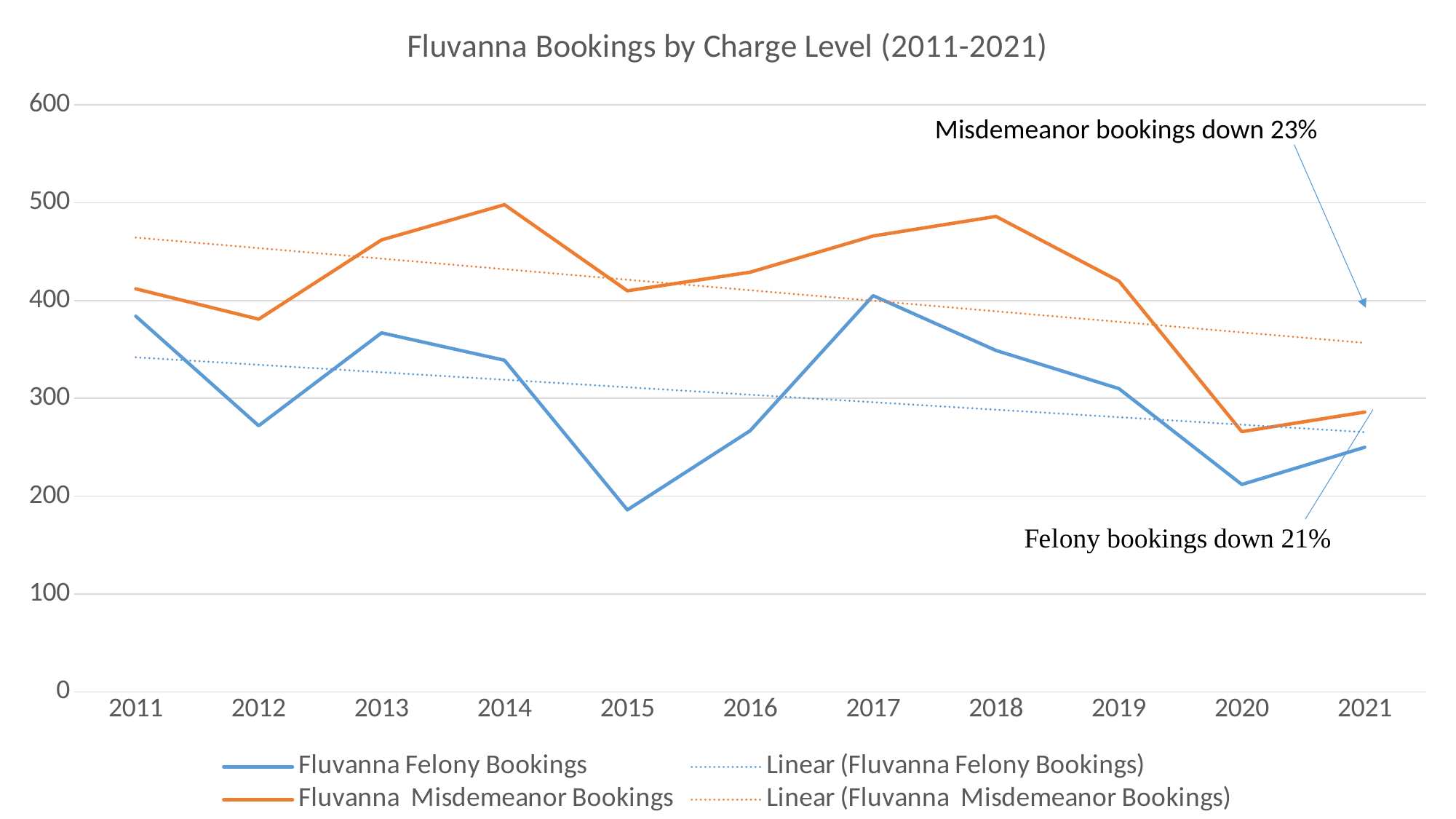
How many years are plotted along the x axis? 11 In 2017, which series has the larger value: Fluvanna Felony Bookings or Fluvanna Misdemeanor Bookings? Fluvanna Misdemeanor Bookings Is the value for Fluvanna Misdemeanor Bookings in 2020 greater or less than 300? less Is the value for Fluvanna Misdemeanor Bookings in 2014 greater or less than 450? greater How many entries does the legend list? 4 By what percentage does the annotation say misdemeanor bookings are down? 23% According to the dotted trend lines, do bookings generally rise or fall from 2011 to 2021? Fall Is the value for Fluvanna Felony Bookings in 2015 greater or less than 200? less What kind of chart is shown on the slide? Line chart In which year were Fluvanna Felony Bookings lowest? 2015 In which year were Fluvanna Felony Bookings highest? 2017 In which year were Fluvanna Misdemeanor Bookings lowest? 2020